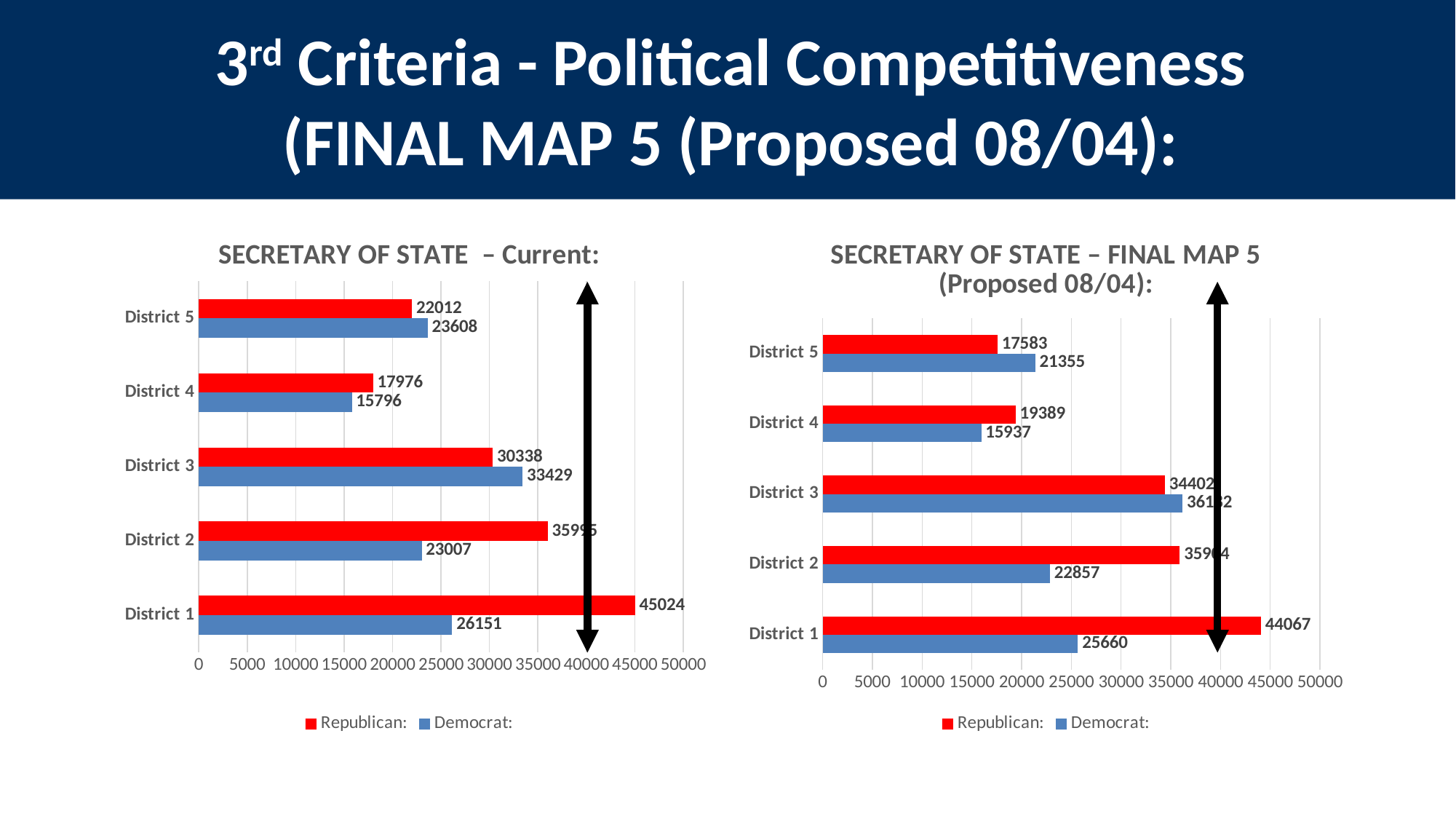
In the 'SECRETARY OF STATE – FINAL MAP 5 (Proposed 08/04)' chart, which district has the highest Republican value? District 1 In the 'SECRETARY OF STATE – FINAL MAP 5 (Proposed 08/04)' chart, which is larger for District 2, the Republican or the Democrat value? Republican In the 'SECRETARY OF STATE – Current' chart, which district has the lowest Democrat value? District 4 In the 'SECRETARY OF STATE – Current' chart, is the Republican value for District 5 greater or less than 25000? less In the 'SECRETARY OF STATE – FINAL MAP 5 (Proposed 08/04)' chart, what is the Democrat value for District 5? 21355 In the 'SECRETARY OF STATE – FINAL MAP 5 (Proposed 08/04)' chart, what is the difference between the Republican and Democrat values for District 1? 18407 What type of chart is the 'SECRETARY OF STATE – FINAL MAP 5 (Proposed 08/04)' chart? Bar chart In the 'SECRETARY OF STATE – Current' chart, what is the Republican value for District 1? 45024 In the 'SECRETARY OF STATE – Current' chart, what is the difference between the Republican and Democrat values for District 1? 18873 How many districts are shown in the 'SECRETARY OF STATE – Current' chart? 5 In the 'SECRETARY OF STATE – Current' chart, what is the Democrat value for District 3? 33429 In the 'SECRETARY OF STATE – FINAL MAP 5 (Proposed 08/04)' chart, what is the Republican value for District 4? 19389